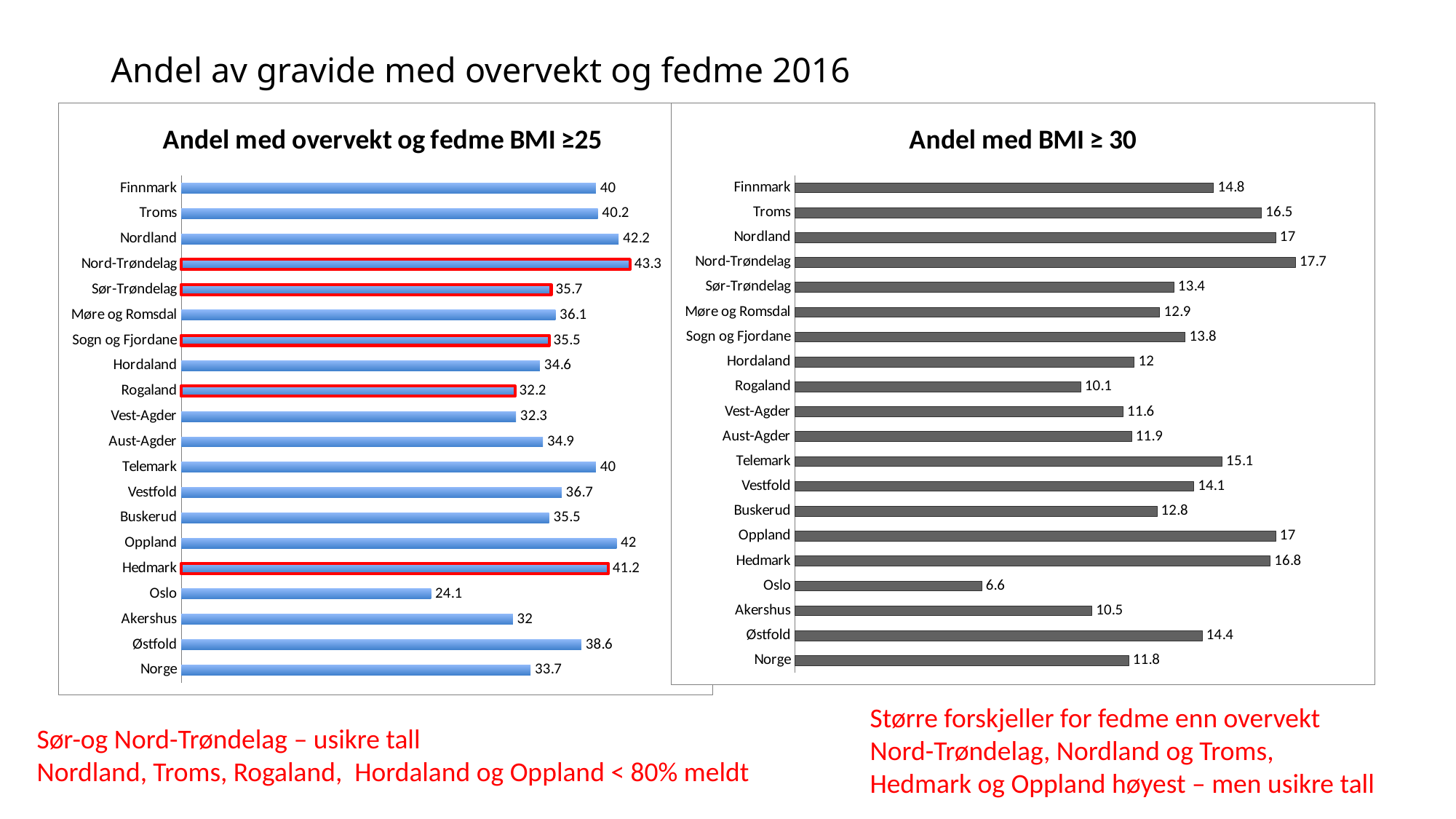
In the chart 'Andel med overvekt og fedme BMI ≥25', what is the value for Norge? 33.7 In the chart 'Andel med BMI ≥ 30', which category has the lowest value? Oslo What is the title of the chart on the right side of the slide? Andel med BMI ≥ 30 How many categories are shown in the chart 'Andel med BMI ≥ 30'? 20 In the chart 'Andel med overvekt og fedme BMI ≥25', which category has the highest value? Nord-Trøndelag In the chart 'Andel med BMI ≥ 30', what is the value for Oslo? 6.6 In the chart 'Andel med overvekt og fedme BMI ≥25', what is the difference between the values for Nord-Trøndelag and Oslo? 19.2 In the chart 'Andel med overvekt og fedme BMI ≥25', what is the value for Hedmark? 41.2 In the chart 'Andel med BMI ≥ 30', what is the difference between the values for Nord-Trøndelag and Norge? 5.9 In the chart 'Andel med overvekt og fedme BMI ≥25', which is larger, the value for Østfold or the value for Akershus? Østfold What kind of chart is 'Andel med overvekt og fedme BMI ≥25'? Bar chart In the chart 'Andel med BMI ≥ 30', which is larger, the value for Troms or the value for Finnmark? Troms